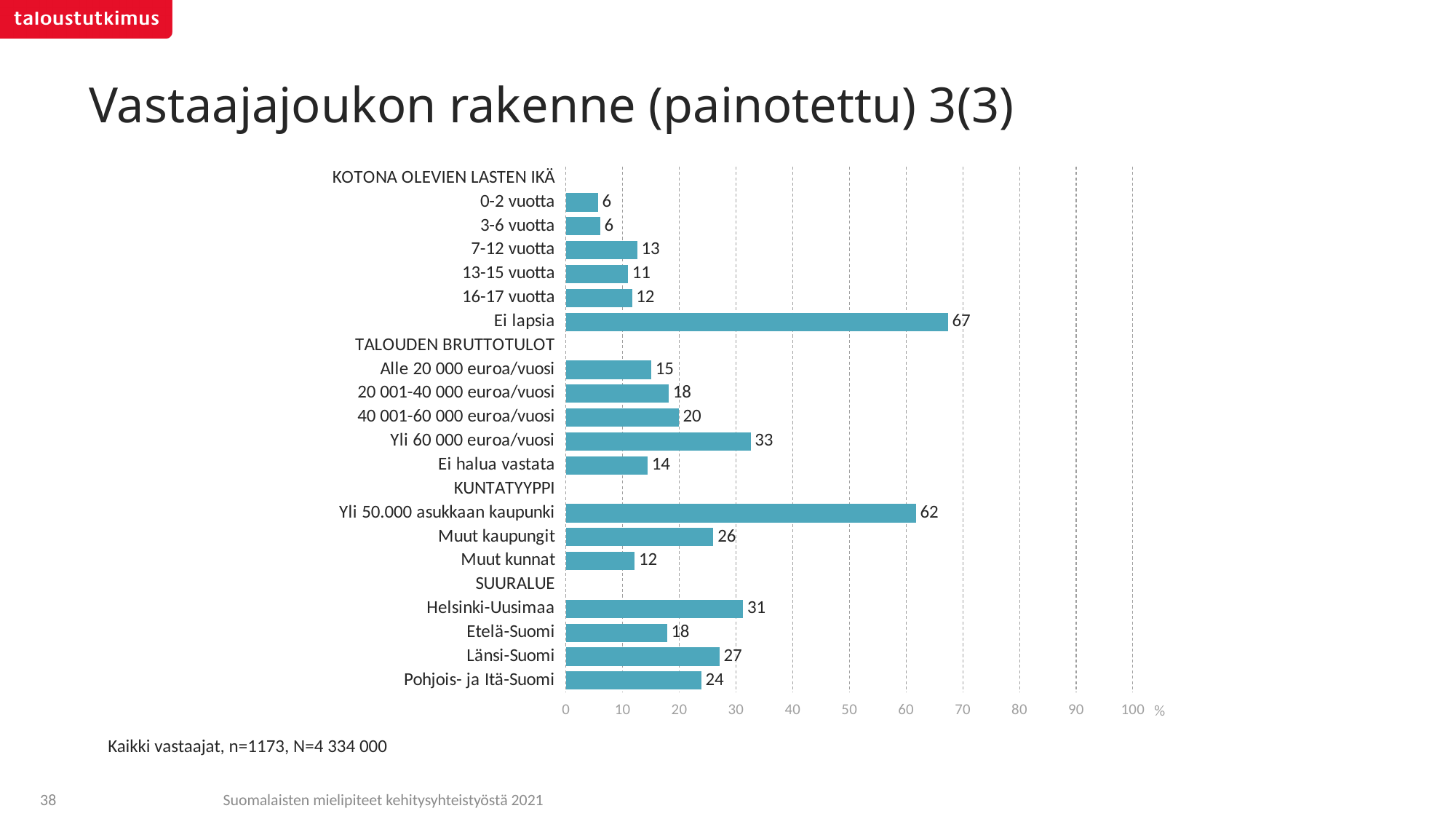
Is the value for Ei lapsia greater or less than 60? greater What is the title of the slide? Vastaajajoukon rakenne (painotettu) 3(3) What is the value for Helsinki-Uusimaa? 31 What is the value for Muut kunnat? 12 What is the value for Yli 60 000 euroa/vuosi? 33 What is the value for Ei lapsia? 67 Which is larger, the value for Länsi-Suomi or the value for Pohjois- ja Itä-Suomi? Länsi-Suomi How many bars are plotted in the chart? 18 Which category under KUNTATYYPPI has the highest value? Yli 50.000 asukkaan kaupunki What kind of chart is shown on the slide? Bar chart What is the difference between the values for Yli 50.000 asukkaan kaupunki and Muut kaupungit? 36 Which category under SUURALUE has the lowest value? Etelä-Suomi